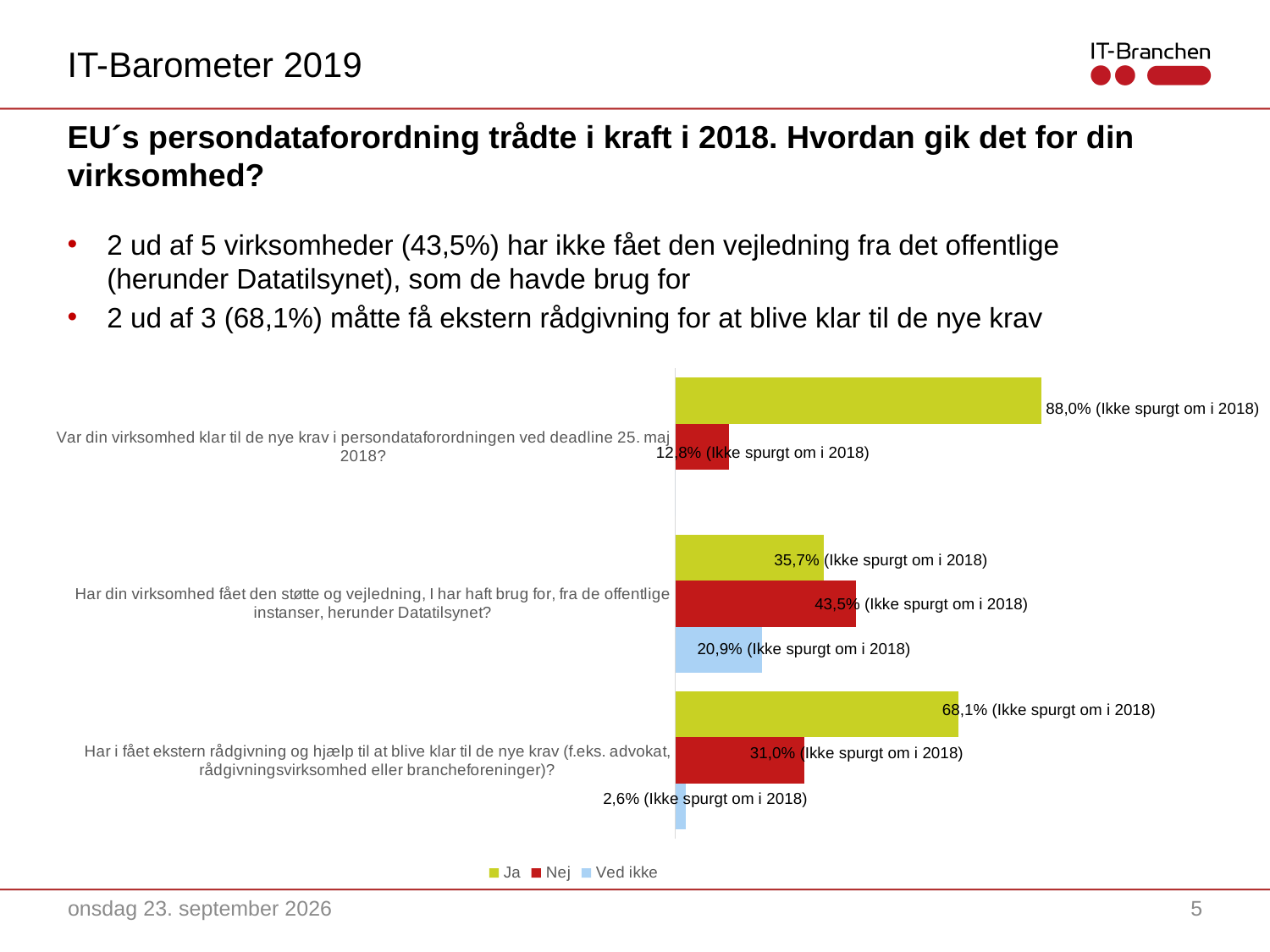
What is the 'Nej' value for the question 'Har din virksomhed fået den støtte og vejledning, I har haft brug for, fra de offentlige instanser, herunder Datatilsynet?'? 43,5% How many series does the chart legend list? 3 What is the 'Nej' value for the question 'Var din virksomhed klar til de nye krav i persondataforordningen ved deadline 25. maj 2018?'? 12,8% What is the 'Ved ikke' value for the question 'Har i fået ekstern rådgivning og hjælp til at blive klar til de nye krav (f.eks. advokat, rådgivningsvirksomhed eller brancheforeninger)?'? 2,6% What is the 'Ved ikke' value for the question 'Har din virksomhed fået den støtte og vejledning, I har haft brug for, fra de offentlige instanser, herunder Datatilsynet?'? 20,9% Which question has the highest 'Ja' value? Var din virksomhed klar til de nye krav i persondataforordningen ved deadline 25. maj 2018? What is the difference between the 'Ja' and 'Nej' values for the question about external advice (ekstern rådgivning)? 37,1% What kind of chart is shown on the slide? bar chart How many questions (categories) are shown on the chart? 3 What is the 'Ja' value for the question 'Har i fået ekstern rådgivning og hjælp til at blive klar til de nye krav (f.eks. advokat, rådgivningsvirksomhed eller brancheforeninger)?'? 68,1% For the question about support from public authorities (herunder Datatilsynet), which is larger: the 'Ja' value or the 'Nej' value? Nej What is the 'Ja' value for the question 'Var din virksomhed klar til de nye krav i persondataforordningen ved deadline 25. maj 2018?'? 88,0%